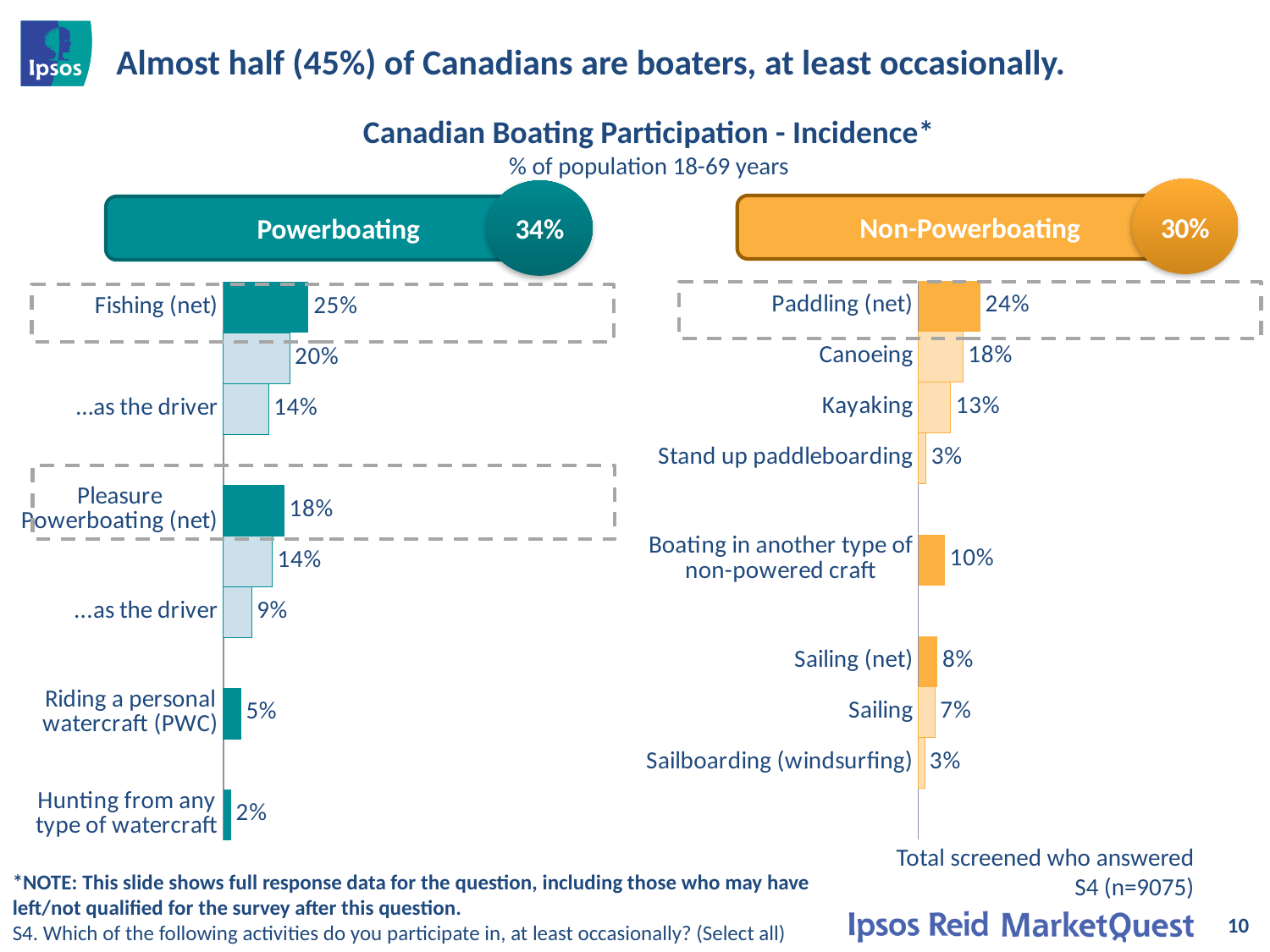
In the Powerboating chart, what is the difference between Fishing (net) and Pleasure Powerboating (net)? 7% In the Non-Powerboating chart, which is larger: Sailing (net) or Stand up paddleboarding? Sailing (net) Which is larger: Fishing (net) in the Powerboating chart or Paddling (net) in the Non-Powerboating chart? Fishing (net) In the Non-Powerboating chart, what is the value for Boating in another type of non-powered craft? 10% In the Non-Powerboating chart, which category has the highest value? Paddling (net) In the Non-Powerboating chart, what is the difference between Canoeing and Kayaking? 5% What overall percentage is shown in the circle next to the Non-Powerboating header? 30% In the Powerboating chart, what is the value for Fishing (net)? 25% What type of chart is used on this slide? Bar chart In the Non-Powerboating chart, what is the value for Kayaking? 13% In the Powerboating chart, what is the value for Riding a personal watercraft (PWC)? 5% In the Powerboating chart, which category has the lowest value? Hunting from any type of watercraft